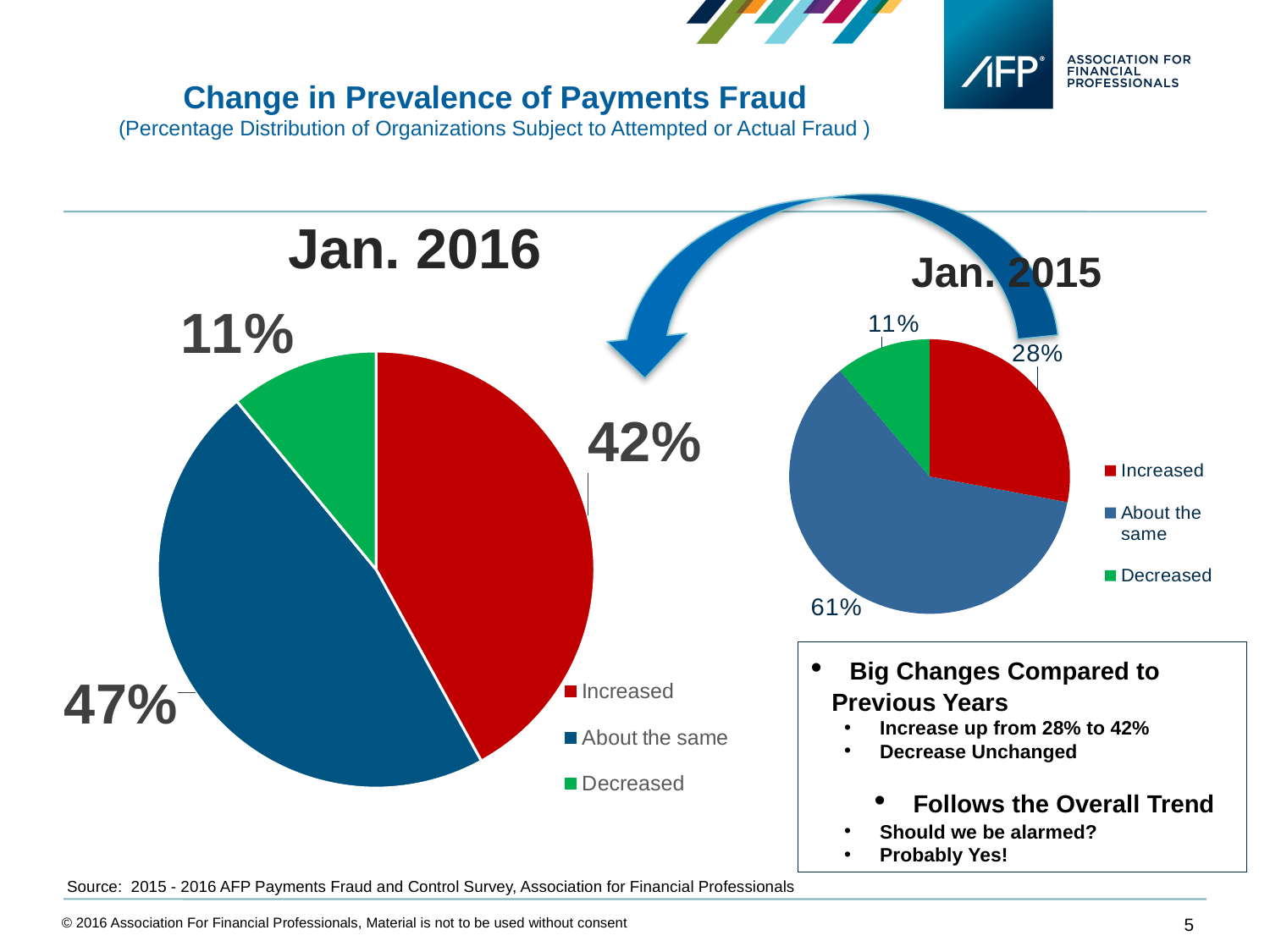
In the Jan. 2015 pie chart, what percentage is shown for 'Increased'? 28% What type of chart is used for the Jan. 2016 data? Pie chart In the Jan. 2015 pie chart, which category has the smallest share? Decreased In the Jan. 2015 pie chart, what percentage is shown for 'Decreased'? 11% What is the difference between the 'Increased' share in Jan. 2016 and the 'Increased' share in Jan. 2015? 14 percentage points Which is larger: the 'About the same' share in Jan. 2015 or the 'About the same' share in Jan. 2016? Jan. 2015 In the Jan. 2016 pie chart, what percentage is shown for 'About the same'? 47% In the Jan. 2016 pie chart, which category has the largest share? About the same In the Jan. 2015 pie chart, what percentage is shown for 'About the same'? 61% How many categories does the legend of the Jan. 2016 pie chart list? 3 In the Jan. 2016 pie chart, what colour represents the 'Decreased' category? Green In the Jan. 2016 pie chart, what percentage of organizations reported that payments fraud increased? 42%